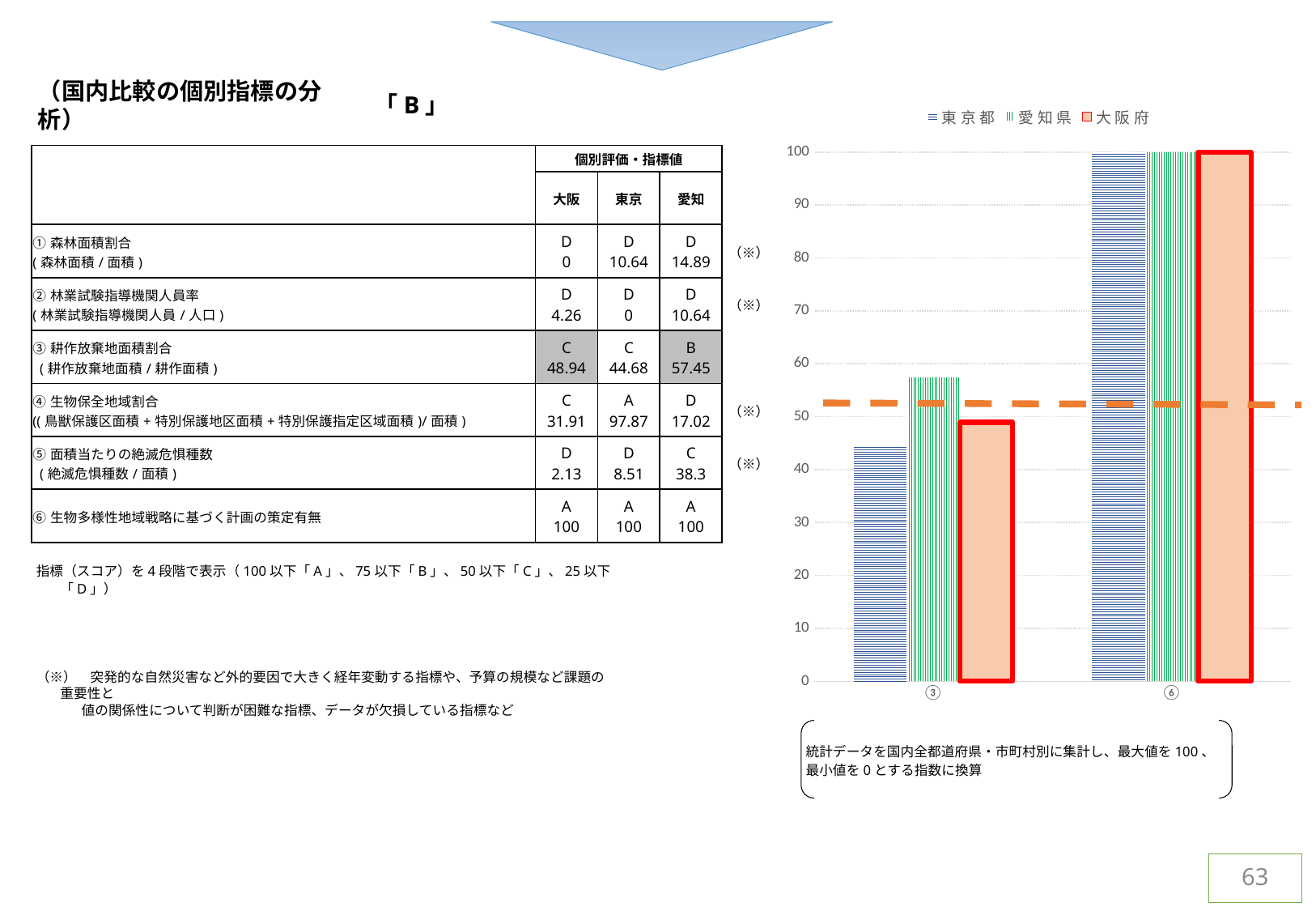
How many series does the legend of the bar chart list? 3 Which series in the bar chart is drawn with a solid orange fill and a red outline? 大阪府 How many categories are shown on the x axis of the bar chart? 2 What kind of chart is shown on the right side of the slide? bar chart Which series has the highest bar for category ③ in the bar chart? 愛知県 What is the value for 大阪府 in category ⑥ in the bar chart? 100 Which series has the lowest bar for category ③ in the bar chart? 東京都 In the bar chart, which is larger for category ③: 愛知県 or 東京都? 愛知県 In the bar chart, is the value for 東京都 in category ③ greater or less than 50? less In the bar chart, is the value for 大阪府 in category ③ greater or less than 40? greater What is the value for 東京都 in category ⑥ in the bar chart? 100 In the bar chart, is the value for 愛知県 in category ③ greater or less than 50? greater